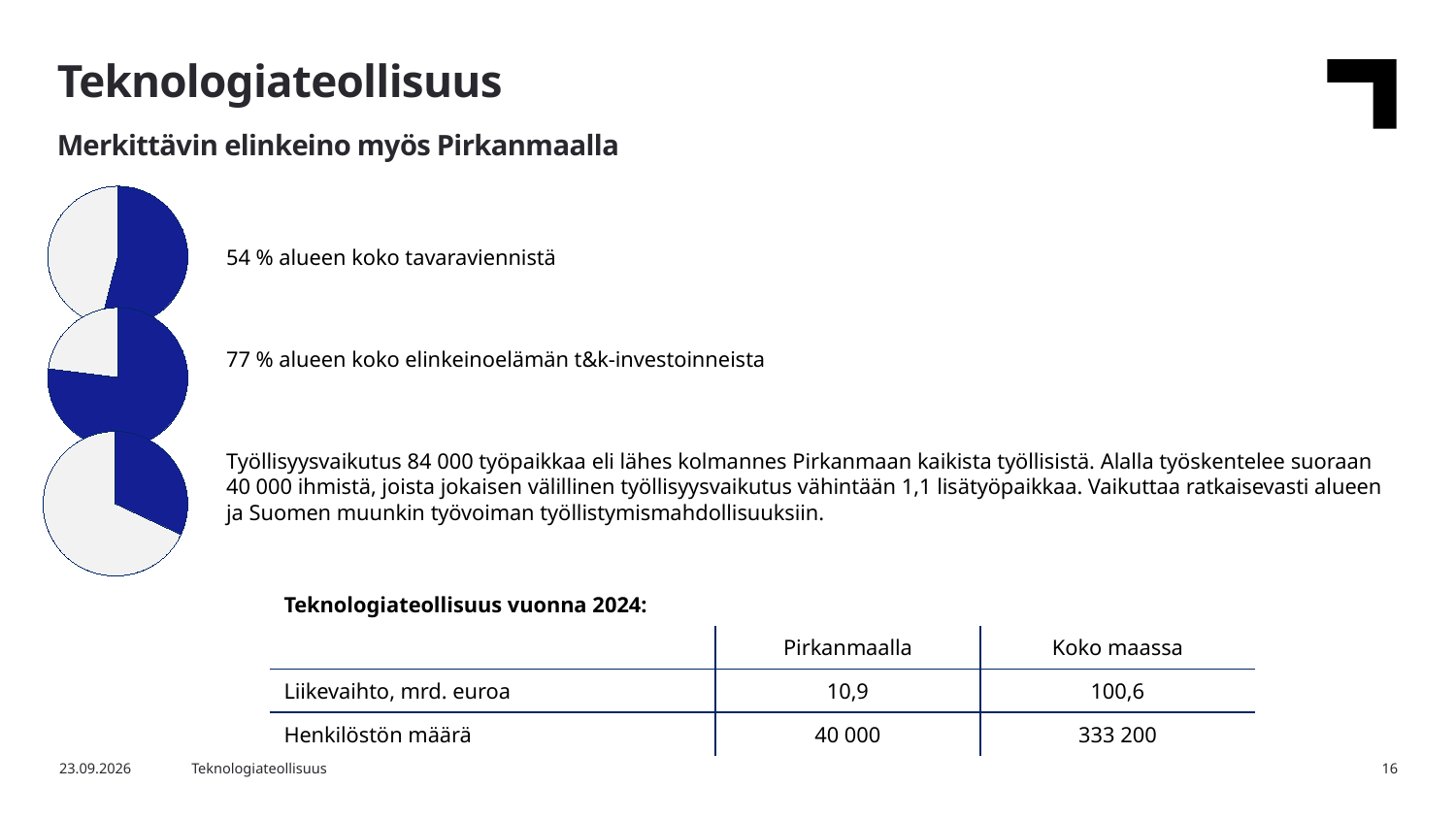
Which of the three pie charts has the smallest blue slice? The bottom one What colour is used for the highlighted slice in each pie chart? Blue What is the difference in percentage points between the shares shown by the middle pie chart (77 %) and the top pie chart (54 %)? 23 percentage points In the middle pie chart, what share of the region's business R&D investments (t&k-investoinnit) does the blue slice represent? 77 % Is the blue slice in the bottom pie chart greater or less than half of the pie? less In the top pie chart, what share of the region's total goods exports (tavaravienti) does the blue slice represent? 54 % Which of the three pie charts has the largest blue slice? The middle one Is the blue slice in the middle pie chart greater or less than half of the pie? greater Which pie chart has the larger blue slice, the top one or the middle one? The middle one How many pie charts are on the slide? 3 What kind of charts are shown on the left side of the slide? Pie charts How many slices does each pie chart have? 2